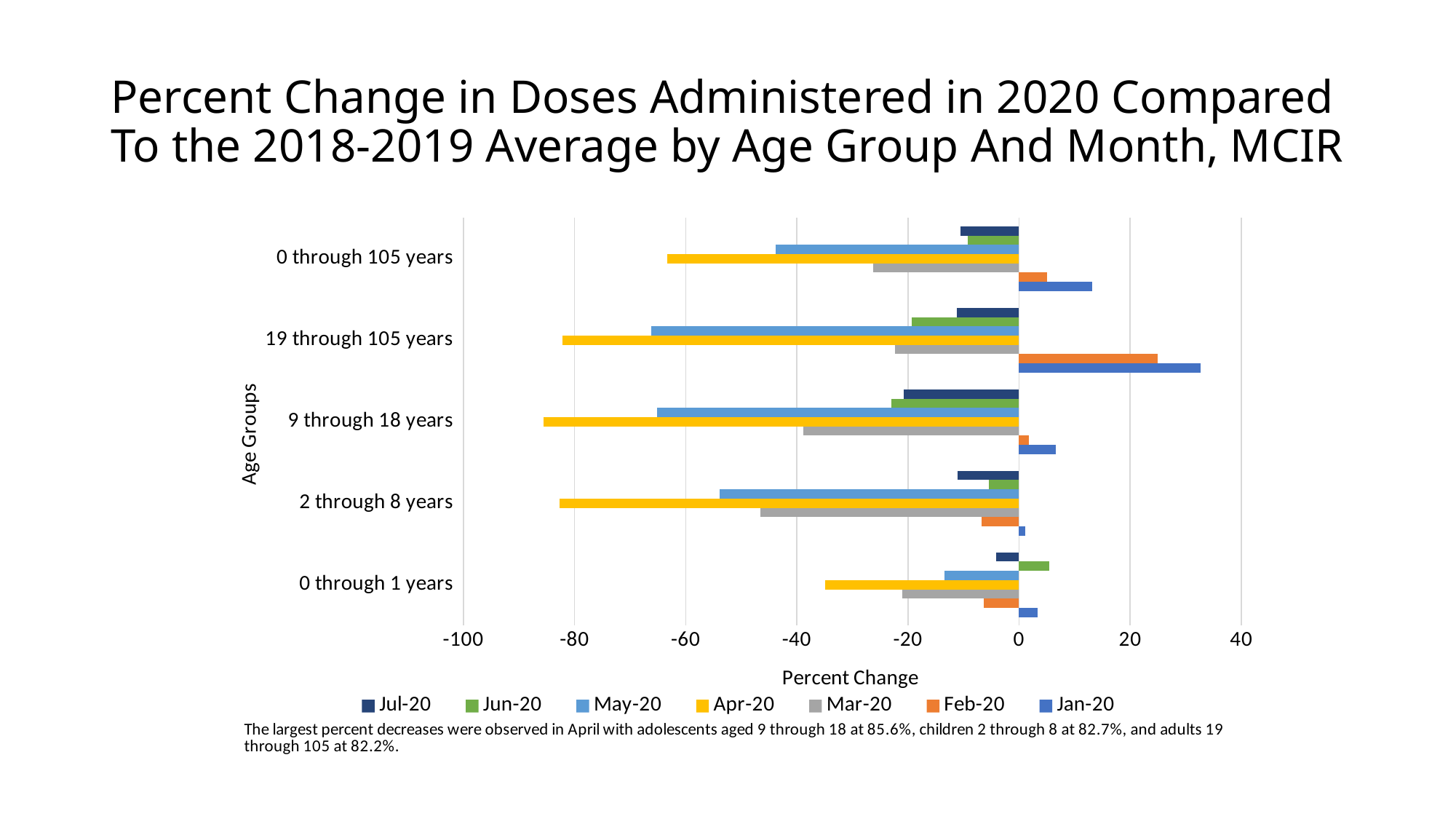
For the 9 through 18 years group, which month has the lowest value? Apr-20 Is the Jan-20 value for 19 through 105 years greater or less than 20? greater How many age groups are shown on the chart? 5 Is the May-20 value for 2 through 8 years greater or less than -40? less What is the title of the vertical axis? Age Groups How many series does the legend list? 7 What kind of chart is shown on the slide? bar chart Is the Apr-20 value for 0 through 105 years greater or less than -60? less Which age group has the highest Jan-20 value? 19 through 105 years According to the note below the chart, what was the percent decrease in April for adolescents aged 9 through 18? 85.6% Which is larger, the Jan-20 value for 19 through 105 years or the Jan-20 value for 0 through 105 years? 19 through 105 years What is the title of the horizontal axis? Percent Change